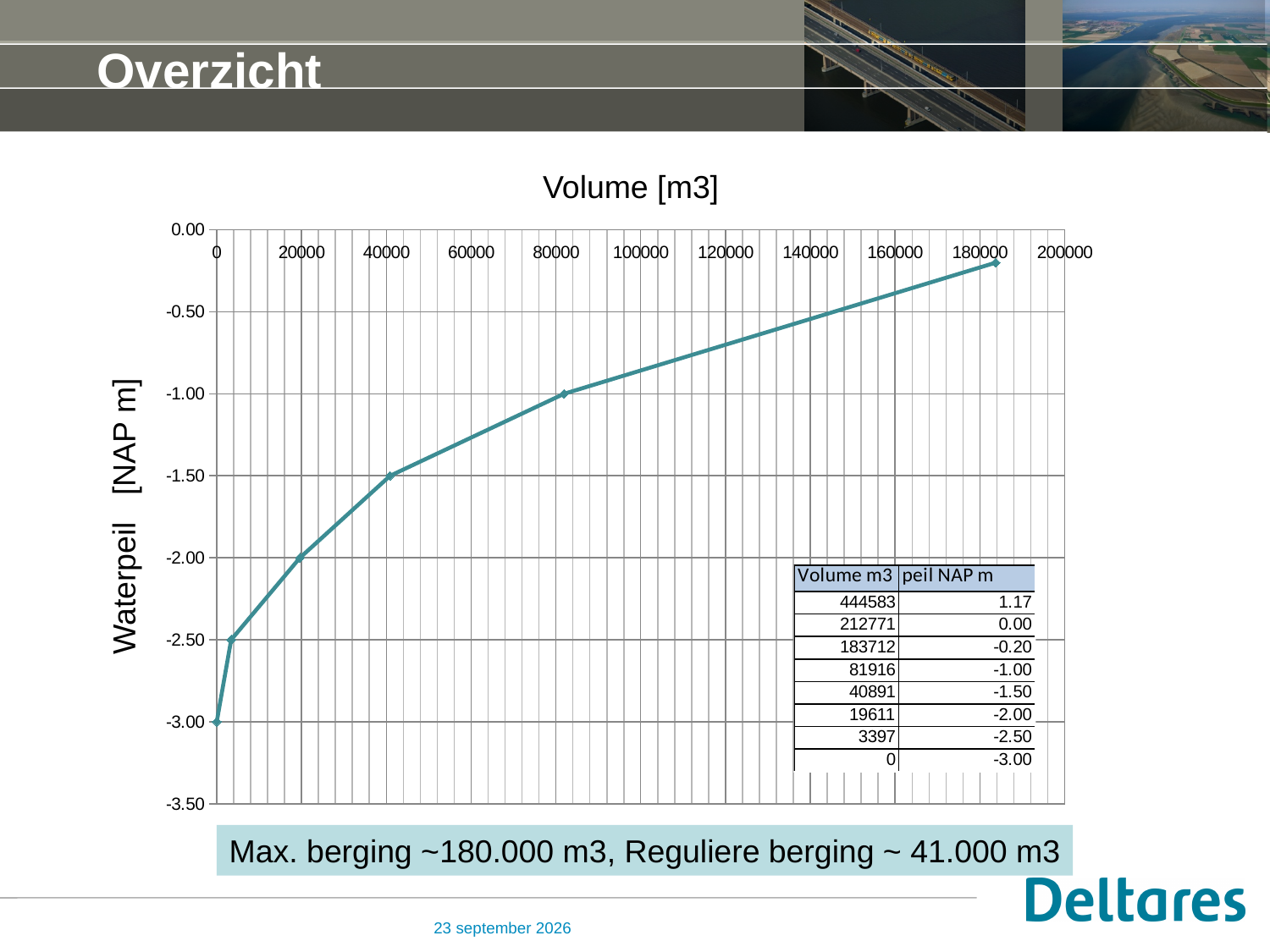
As the volume increases along the x axis, does the water level rise or fall? rise According to the table on the chart, what volume corresponds to a water level of -2.50 NAP m? 3397 What kind of chart is shown on the slide? line chart What is the highest water level plotted on the chart? -0.20 How many data points are plotted on the line in the chart? 6 What is the lowest water level plotted on the chart? -3.00 What is the difference in volume between the points at -1.00 NAP m and -1.50 NAP m, using the table values? 41025 According to the table on the chart, what volume corresponds to a water level of -1.00 NAP m? 81916 According to the table on the chart, what volume corresponds to a water level of -1.50 NAP m? 40891 What is the title shown above the chart? Volume [m3] According to the table on the chart, what water level corresponds to a volume of 183712 m3? -0.20 What is the label of the vertical axis of the chart? Waterpeil [NAP m]